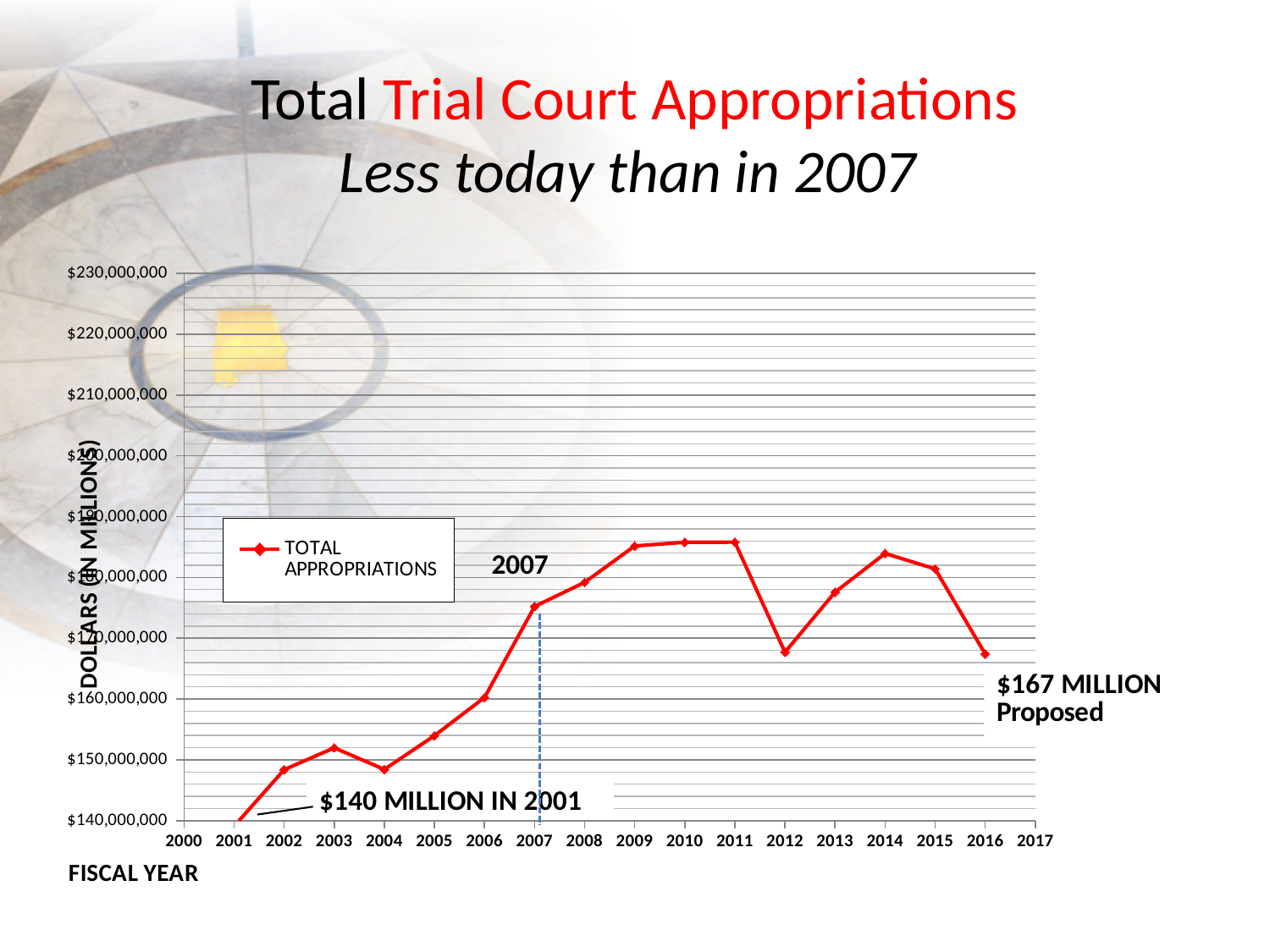
What kind of chart is shown on the slide? line chart According to the annotation, what is the proposed amount for 2016? $167 million Which is larger, the value for 2012 or the value for 2014? 2014 How much larger is the $167 million proposed for 2016 than the $140 million in 2001? $27 million What is the label on the x axis? FISCAL YEAR How many series does the legend list? 1 Which fiscal year has the lowest total appropriation? 2001 What is the name of the series shown in the legend? TOTAL APPROPRIATIONS Is the value for 2010 greater or less than $180,000,000? greater According to the annotation, what was the total appropriation in 2001? $140 million Is the value for 2012 greater or less than $170,000,000? less Do the values rise or fall from 2011 to 2012? fall